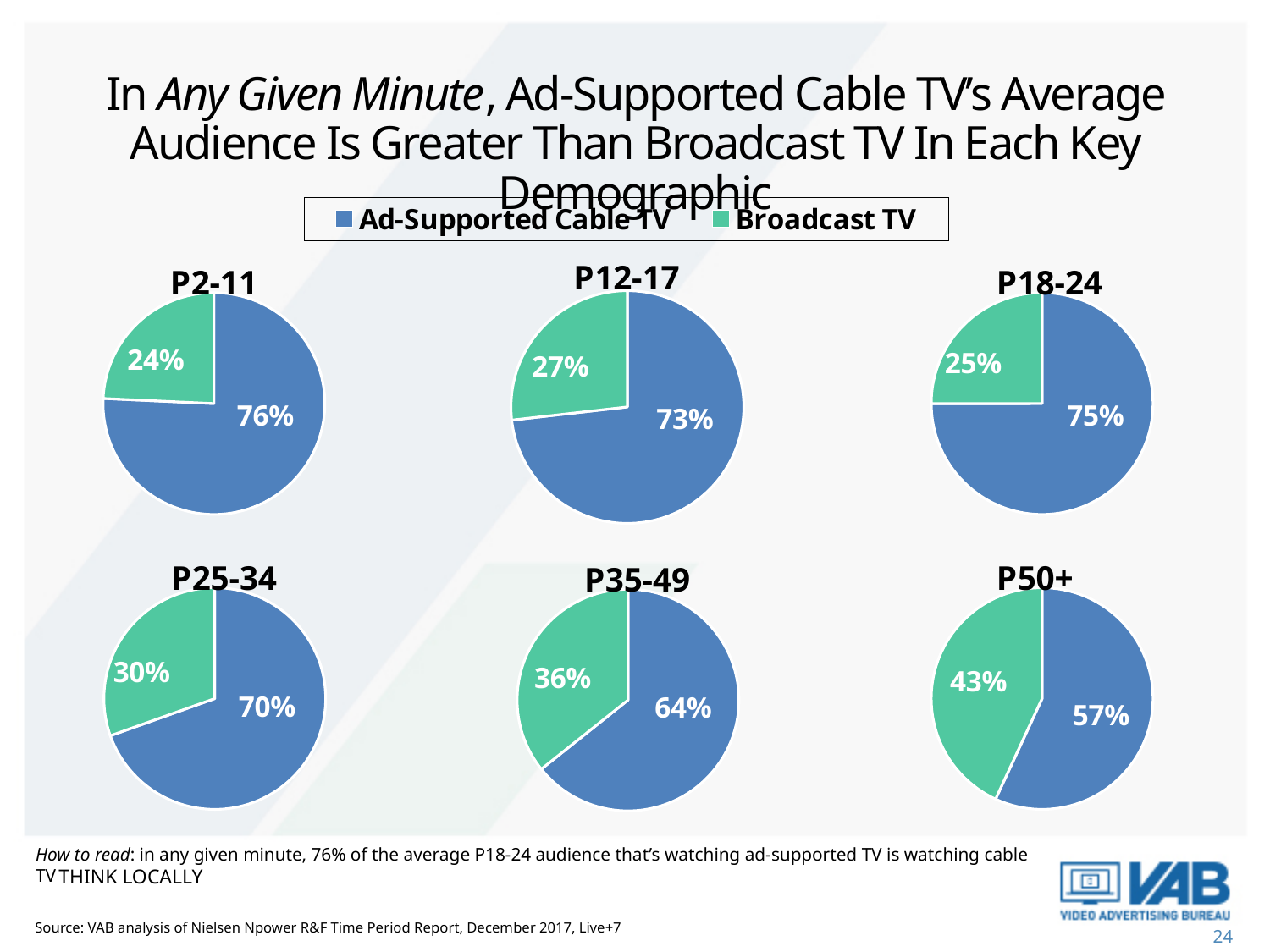
In the P50+ pie chart, what share is Broadcast TV? 43% In the P18-24 pie chart, what share is Ad-Supported Cable TV? 75% In the P25-34 pie chart, what share is Broadcast TV? 30% In the P12-17 pie chart, what share is Broadcast TV? 27% Across the six pie charts, which demographic has the highest Broadcast TV share? P50+ In the P50+ pie chart, what is the difference between the Ad-Supported Cable TV share and the Broadcast TV share? 14% How many pie charts are shown on the slide? 6 In the P35-49 pie chart, which is larger, Ad-Supported Cable TV or Broadcast TV? Ad-Supported Cable TV In the P2-11 pie chart, what share is Ad-Supported Cable TV? 76% How many series does the legend list? 2 Across the six pie charts, which demographic has the lowest Broadcast TV share? P2-11 In the P35-49 pie chart, what share is Ad-Supported Cable TV? 64%